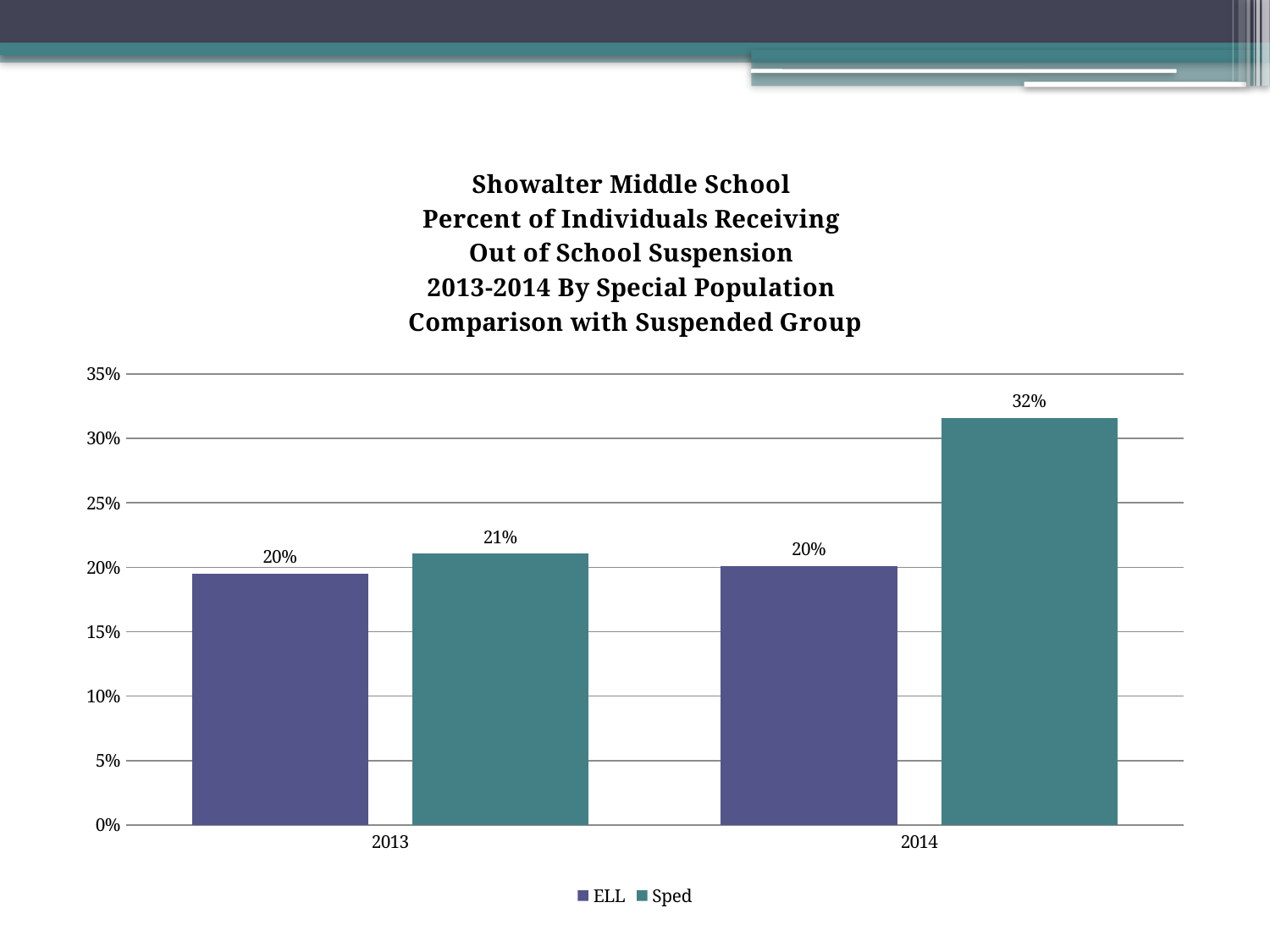
What is the value for Sped in 2013? 21% What kind of chart is shown? bar chart Does the Sped value rise or fall from 2013 to 2014? rise Which is larger in 2014, ELL or Sped? Sped Which series has the highest value in 2014? Sped What is the difference between the Sped values for 2014 and 2013? 11% What is the value for ELL in 2013? 20% How many categories are shown on the x axis? 2 What is the value for Sped in 2014? 32% How many series does the legend list? 2 What is the value for ELL in 2014? 20% Is the value for Sped in 2014 greater or less than 30%? greater